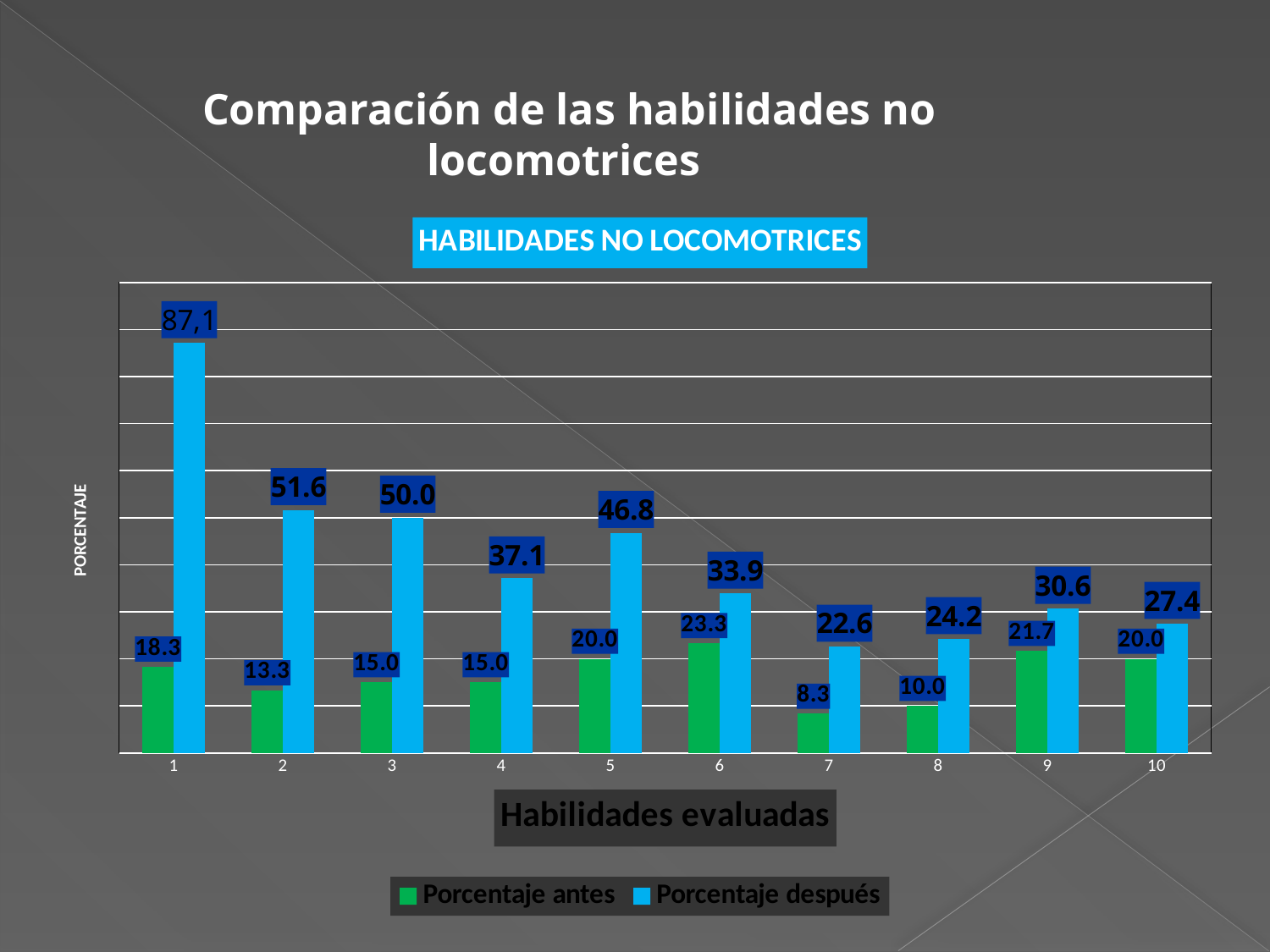
What is the value of Porcentaje antes for category 9? 21.7 Which category has the lowest Porcentaje antes value? 7 Which is larger for category 8: Porcentaje antes or Porcentaje después? Porcentaje después What is the value of Porcentaje después for category 4? 37.1 Which category has the highest Porcentaje después value? 1 What is the value of Porcentaje antes for category 7? 8.3 What is the difference between Porcentaje después and Porcentaje antes for category 2? 38.3 What type of chart is shown on the slide? Bar chart Which category has the highest Porcentaje antes value? 6 How many series does the legend list? 2 How many categories are shown on the x axis? 10 What is the value of Porcentaje después for category 1? 87,1